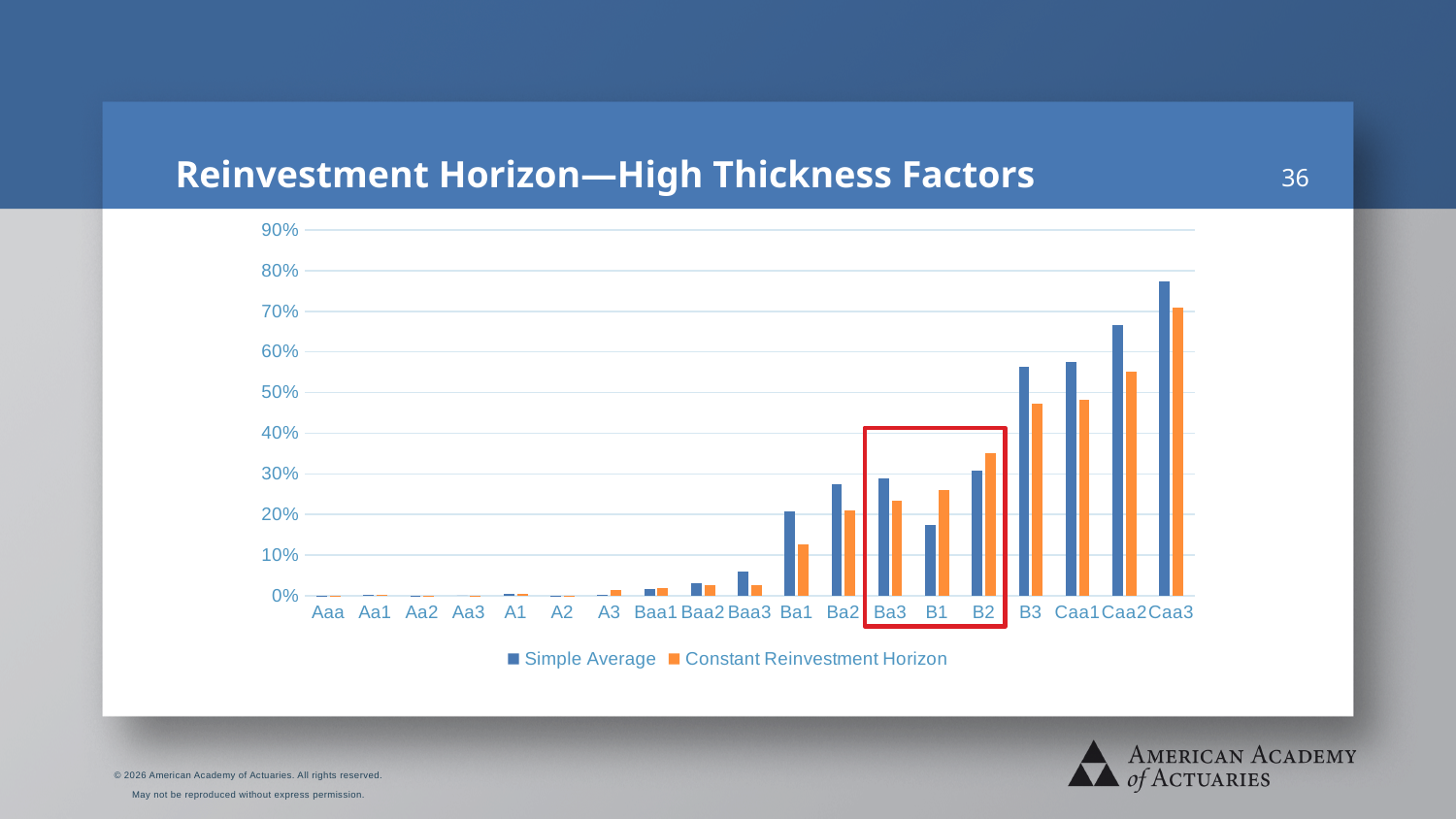
Is the Simple Average value for B3 greater or less than 50%? greater For Ba3, which series has the larger value, Simple Average or Constant Reinvestment Horizon? Simple Average How many series does the legend list? 2 Do the values generally rise or fall moving from Aaa to Caa3 along the x axis? Rise What is the title of the slide containing the chart? Reinvestment Horizon—High Thickness Factors What kind of chart is shown on the slide? Bar chart For B1, which series has the larger value, Simple Average or Constant Reinvestment Horizon? Constant Reinvestment Horizon Is the Constant Reinvestment Horizon value for Caa2 greater or less than 60%? less Which rating category has the highest Simple Average value? Caa3 Is the Simple Average value for Caa3 greater or less than 70%? greater How many rating categories are shown on the x axis? 19 Which rating categories are enclosed by the red box on the chart? Ba3, B1, B2